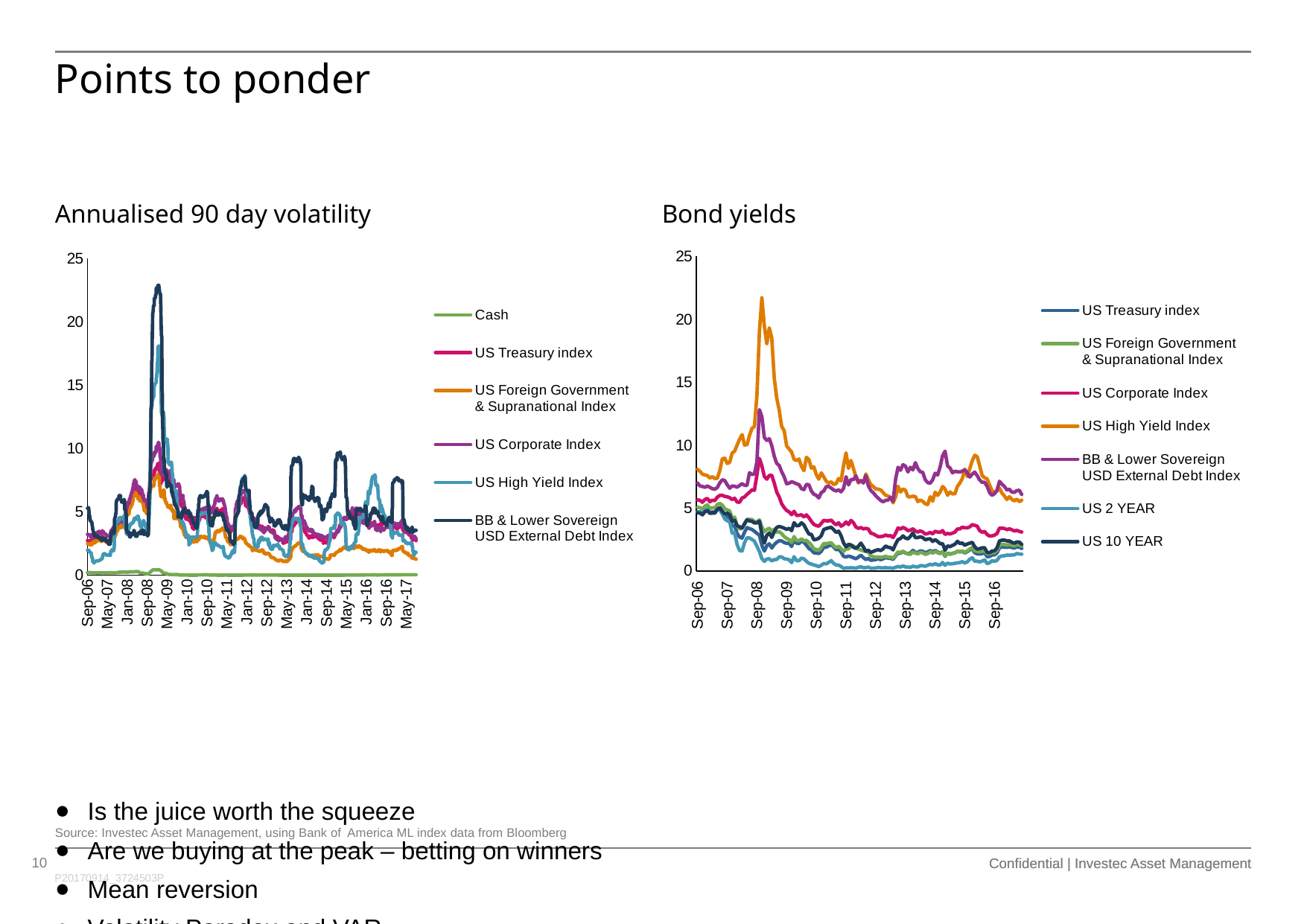
What is the highest value shown on the y axis of the 'Bond yields' chart? 25 How many series does the legend of the 'Bond yields' chart list? 7 In the 'Bond yields' chart, which series reaches the highest peak? US High Yield Index In the 'Annualised 90 day volatility' chart, is the peak value of the BB & Lower Sovereign USD External Debt Index greater or less than 20? greater What kind of chart is the 'Annualised 90 day volatility' chart? line chart In the 'Bond yields' chart, is the peak value of the US High Yield Index greater or less than 20? greater What kind of chart is the 'Bond yields' chart? line chart How many series does the legend of the 'Annualised 90 day volatility' chart list? 6 In the 'Annualised 90 day volatility' chart, which series reaches the highest peak? BB & Lower Sovereign USD External Debt Index In the 'Annualised 90 day volatility' chart, which series stays lowest across the whole period? Cash In the 'Bond yields' chart, is the value for US 2 YEAR at Sep-13 greater or less than 5? less In the 'Bond yields' chart, does the US 10 YEAR series rise or fall overall from Sep-06 to Sep-16? fall